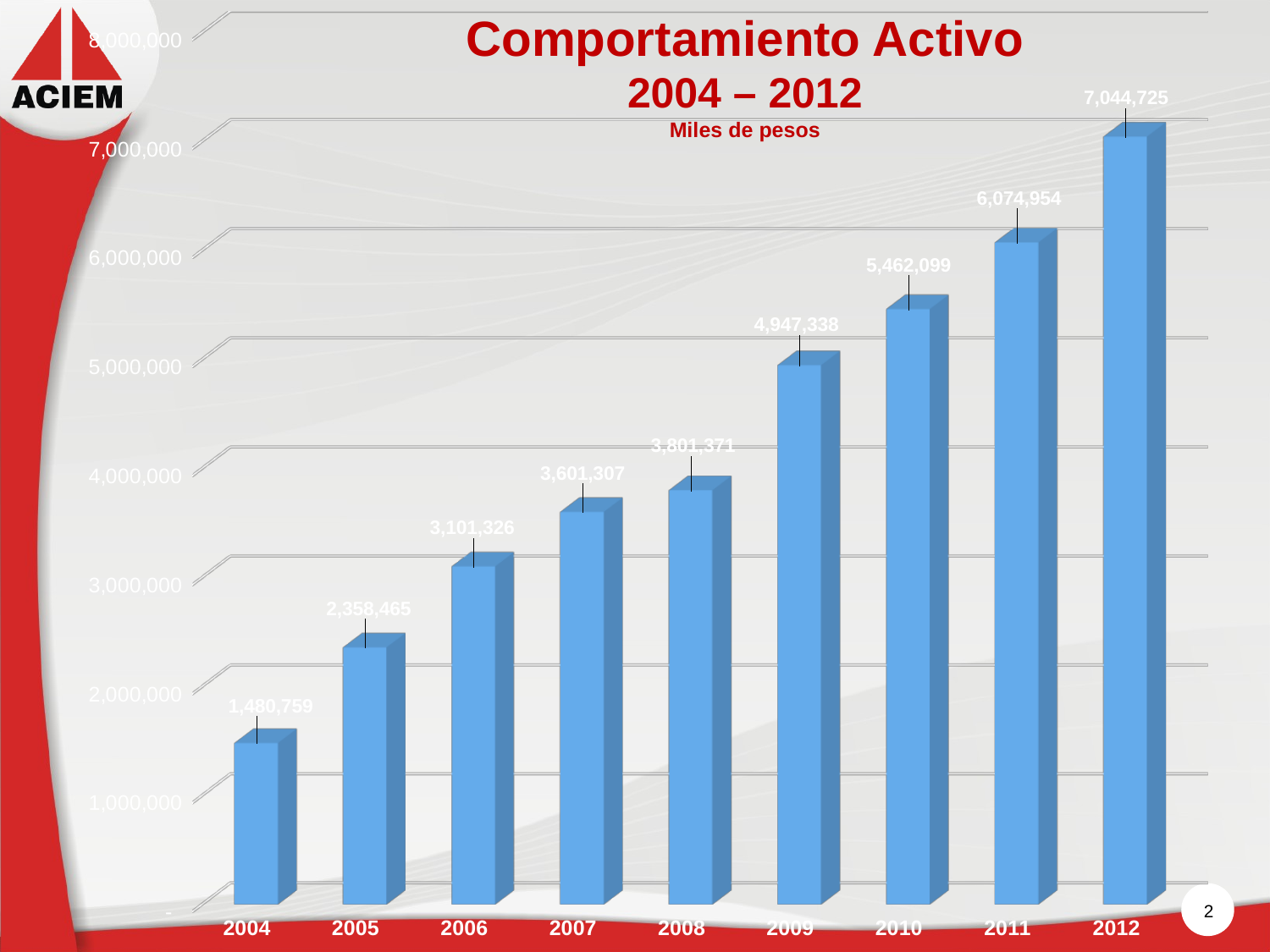
Is the value for 2006 greater or less than 3,000,000? greater Which is larger, the value for 2010 or the value for 2011? 2011 What is the value for 2012? 7,044,725 Which year has the highest value? 2012 Do the values rise or fall from 2004 to 2012? rise What is the value for 2004? 1,480,759 What kind of chart is shown on the slide? bar chart What is the difference between the values for 2012 and 2004? 5,563,966 Which year has the lowest value? 2004 How many years are shown on the x axis? 9 What is the value for 2009? 4,947,338 What is the difference between the values for 2008 and 2007? 200,064